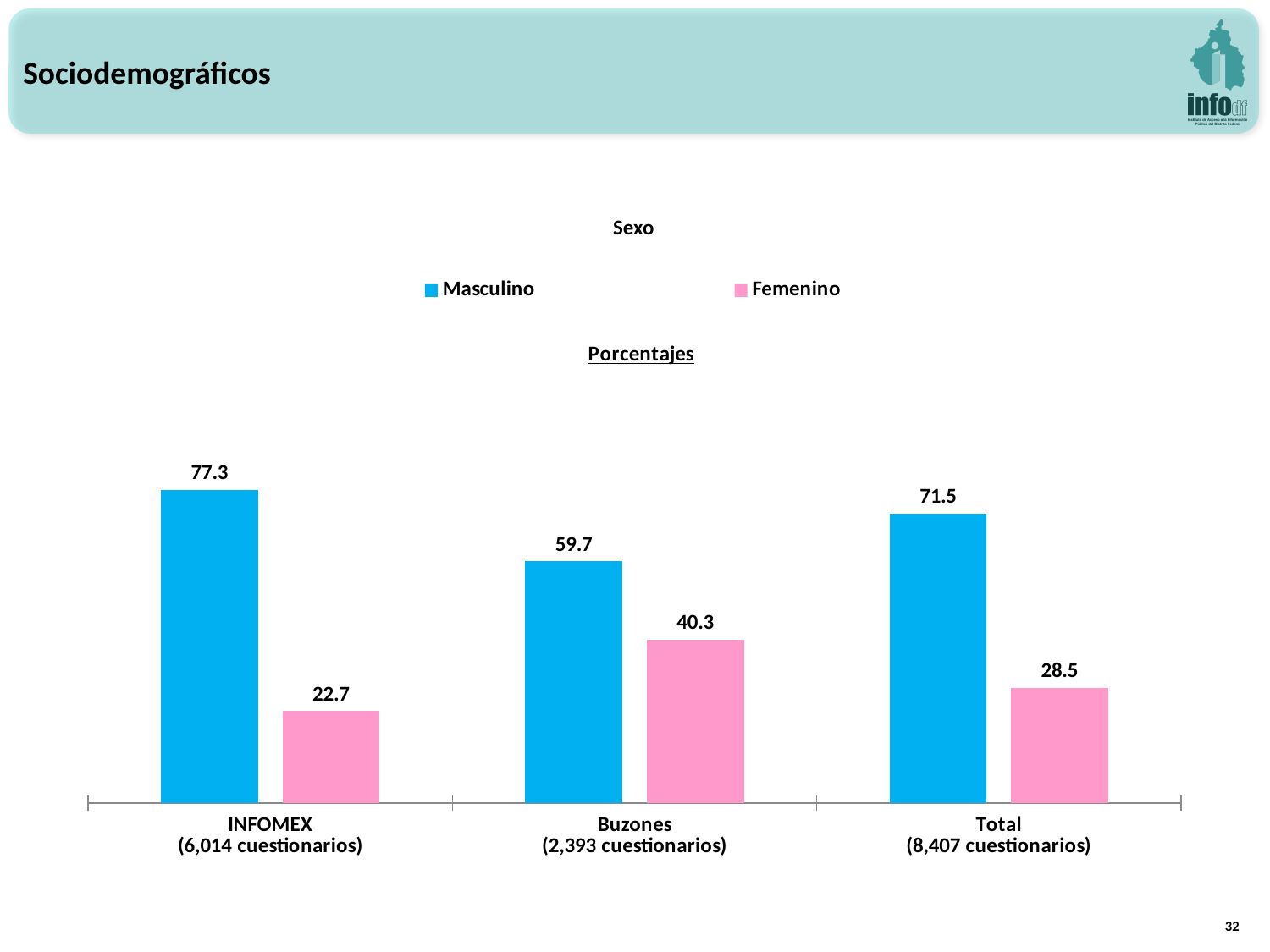
What is the Masculino value for INFOMEX? 77.3 How many categories are shown on the x axis? 3 What is the difference between the Masculino and Femenino values for Buzones? 19.4 What is the title of the chart? Porcentajes Which is larger, the Femenino value for Buzones or the Femenino value for Total? Buzones Which category has the lowest Femenino value? INFOMEX How many series does the legend list? 2 What is the difference between the Masculino values for INFOMEX and Total? 5.8 Which category has the highest Masculino value? INFOMEX What kind of chart is shown on the slide? bar chart What is the Femenino value for Total? 28.5 What is the Femenino value for Buzones? 40.3